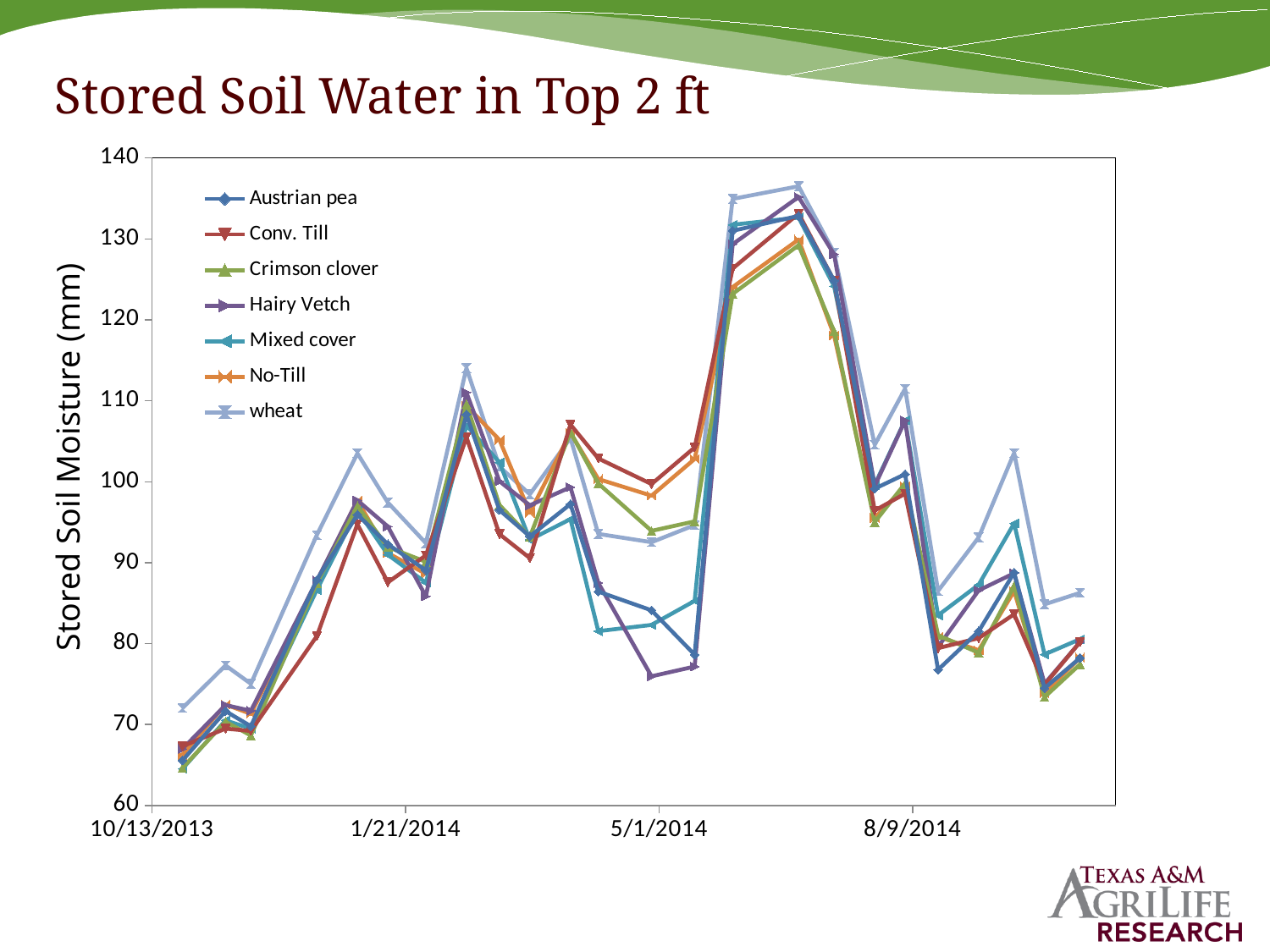
Is the lowest value for Hairy Vetch around 5/1/2014 greater or less than 80? less How many series does the legend list? 7 What kind of chart is shown on the slide? line chart At the peak in summer 2014, is the value for wheat larger or smaller than the value for Crimson clover? larger Is the value for wheat at 10/13/2013 greater or less than 80? less Do the values for wheat rise or fall between 10/13/2013 and 1/21/2014? rise Is the value for Crimson clover at 10/13/2013 greater or less than 70? less Which series reaches the highest value on the chart? wheat What is the title of the chart? Stored Soil Water in Top 2 ft Which series has the highest value at the first date, 10/13/2013? wheat What is the label on the vertical axis? Stored Soil Moisture (mm)